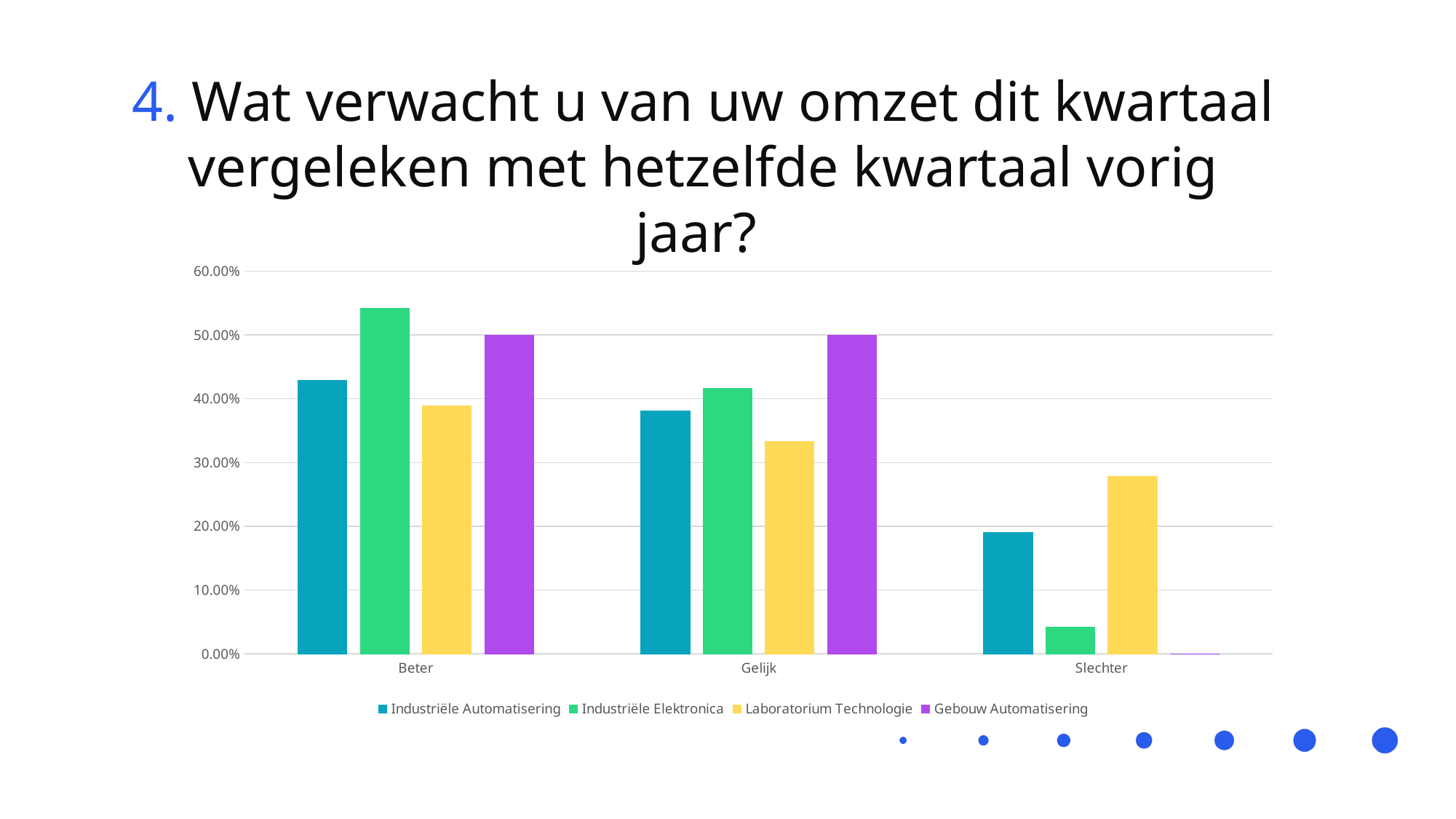
Which is larger in the Slechter category: Laboratorium Technologie or Industriële Automatisering? Laboratorium Technologie Which series has the highest value in the Slechter category? Laboratorium Technologie How many categories are shown on the x axis of the chart? 3 Is the value for Industriële Elektronica in the Slechter category greater or less than 10.00%? less How many series does the chart's legend list? 4 What is the value for Gebouw Automatisering in the Gelijk category? 50.00% What is the value for Gebouw Automatisering in the Beter category? 50.00% Is the value for Industriële Automatisering in the Beter category greater or less than 40.00%? greater What is the value for Gebouw Automatisering in the Slechter category? 0.00% Which series has the highest value in the Beter category? Industriële Elektronica What kind of chart is shown on the slide? bar chart Which series has the lowest value in the Slechter category? Gebouw Automatisering